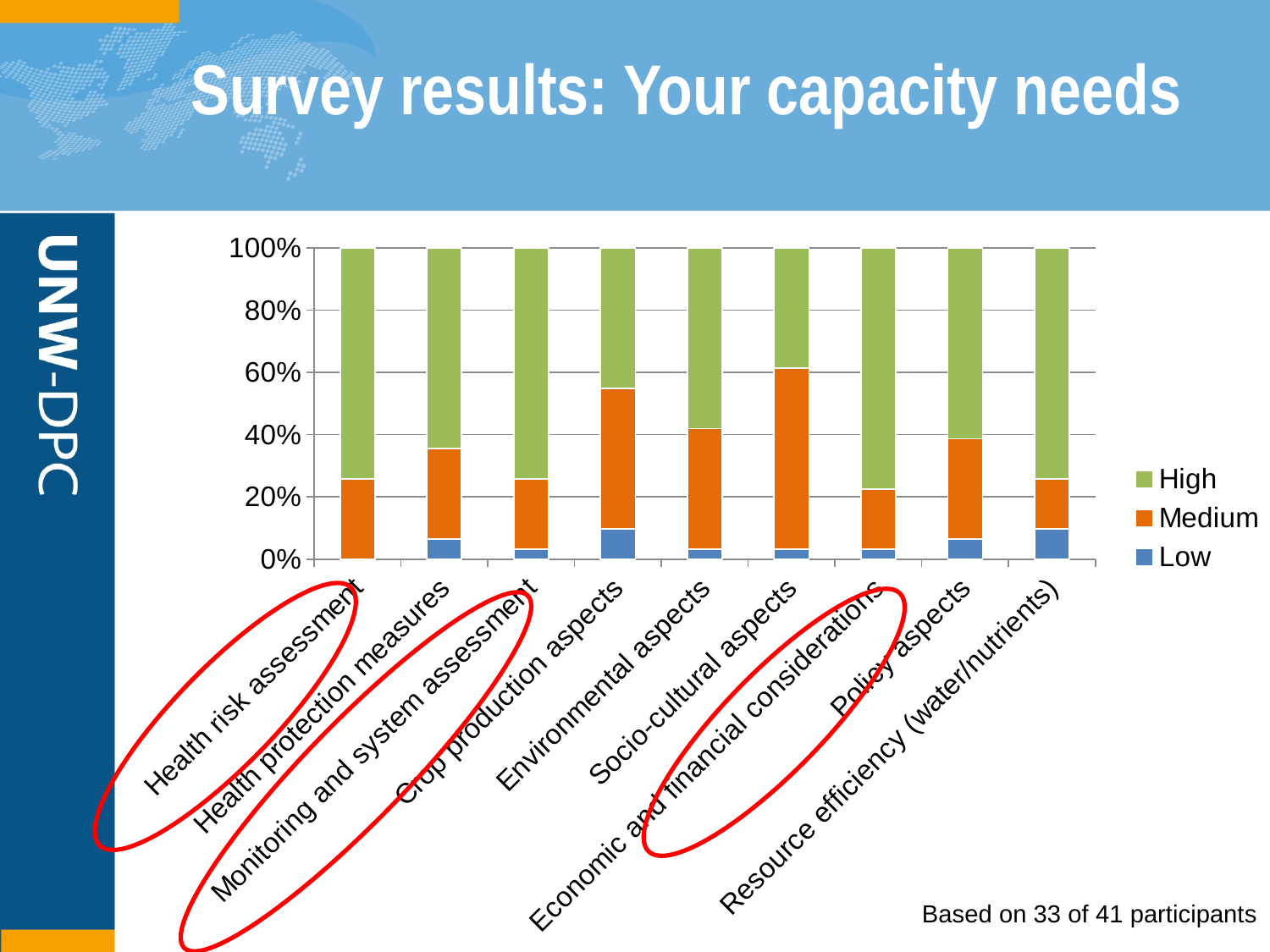
How many series does the chart's legend list? 3 Is the High share for Health risk assessment greater or less than 60%? greater Which has the larger High share: Health risk assessment or Socio-cultural aspects? Health risk assessment Is the Medium share for Health risk assessment greater or less than 20%? greater How many categories are shown along the x axis of the chart? 9 What are the three series listed in the chart's legend? High, Medium, Low Is the combined Medium and Low share for Crop production aspects greater or less than 60%? less What is the title of the slide containing the chart? Survey results: Your capacity needs What kind of chart is shown on the slide? Stacked bar chart Which has the larger Medium share: Socio-cultural aspects or Health risk assessment? Socio-cultural aspects